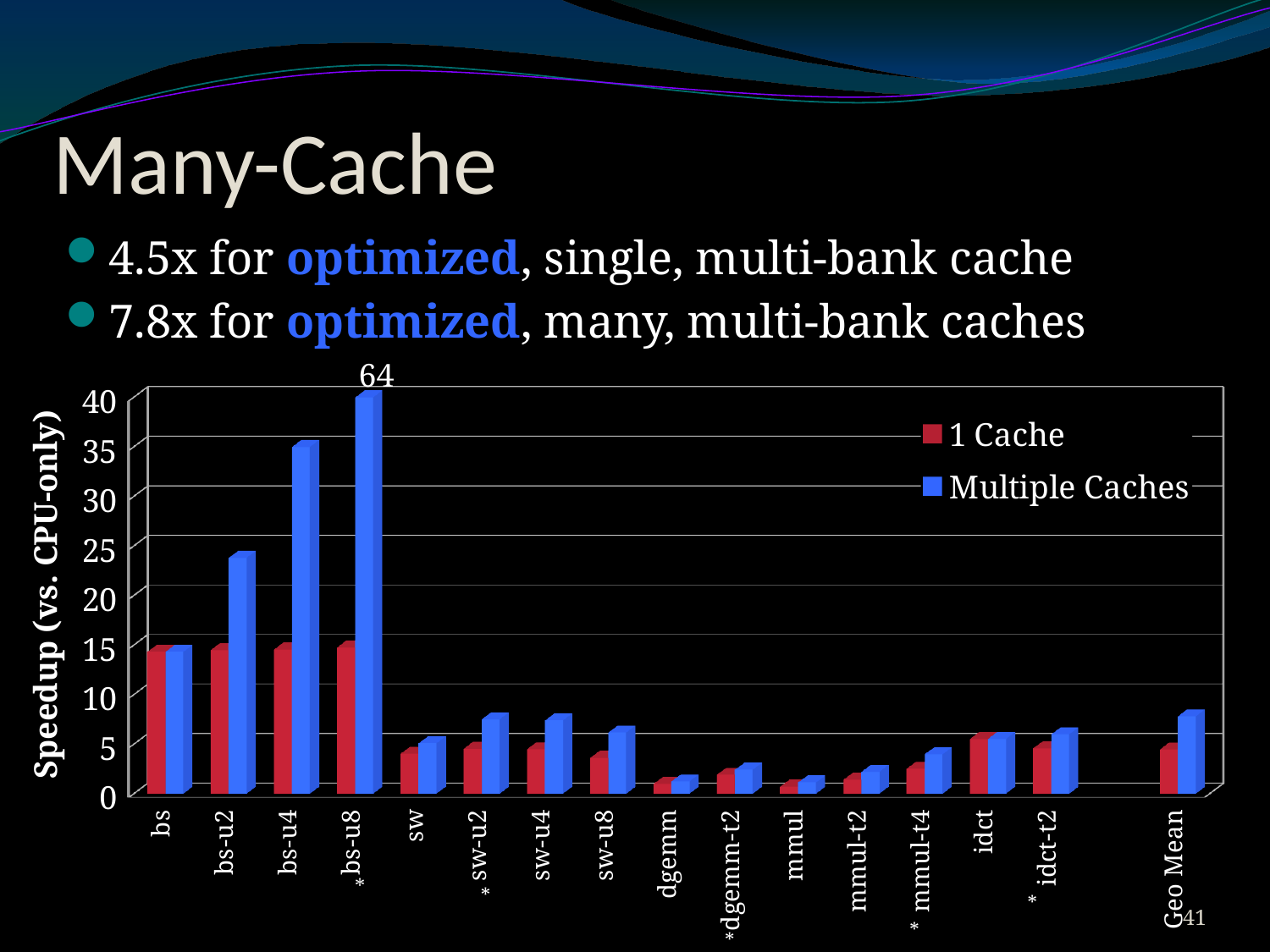
What is the Multiple Caches speedup value for *bs-u8? 64 Which category has the highest Multiple Caches bar? *bs-u8 What is the title of the y axis of the chart? Speedup (vs. CPU-only) Which category has the lowest 1 Cache bar? mmul Is the Multiple Caches value for bs-u2 greater or less than 20? greater How many series does the chart legend list? 2 How many categories are shown along the x axis of the chart? 16 Is the Multiple Caches value for dgemm greater or less than 5? less For Geo Mean, which is larger: the 1 Cache bar or the Multiple Caches bar? Multiple Caches What kind of chart is shown on the slide? bar chart What are the two series names listed in the chart legend? 1 Cache and Multiple Caches Is the Multiple Caches value for bs-u4 greater or less than 30? greater